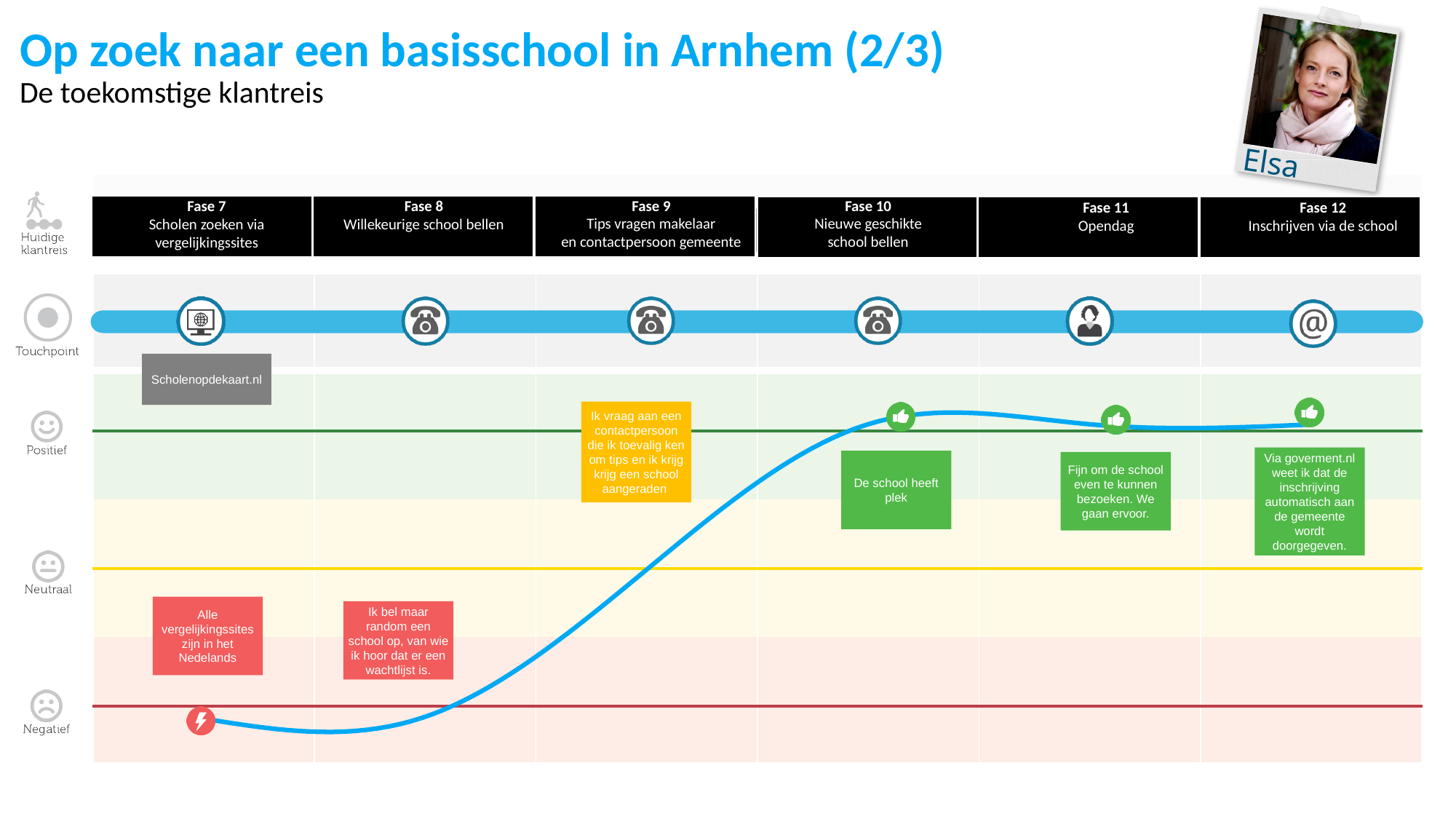
What is the name of Fase 12 in the customer journey chart? Inschrijven via de school What is the subtitle shown under the main title of the slide? De toekomstige klantreis What is the name of the touchpoint website shown under Fase 7? Scholenopdekaart.nl What is the title of the slide containing the customer journey chart? Op zoek naar een basisschool in Arnhem (2/3) How many phases (fases) are shown along the top of the customer journey chart? 6 What is the name of Fase 11 in the customer journey chart? Opendag Does the emotion curve rise or fall from Fase 7 to Fase 10? rise Which phase has a higher position on the emotion curve, Fase 8 or Fase 12? Fase 12 Is the emotion curve in Fase 7 above or below the Neutraal line? below